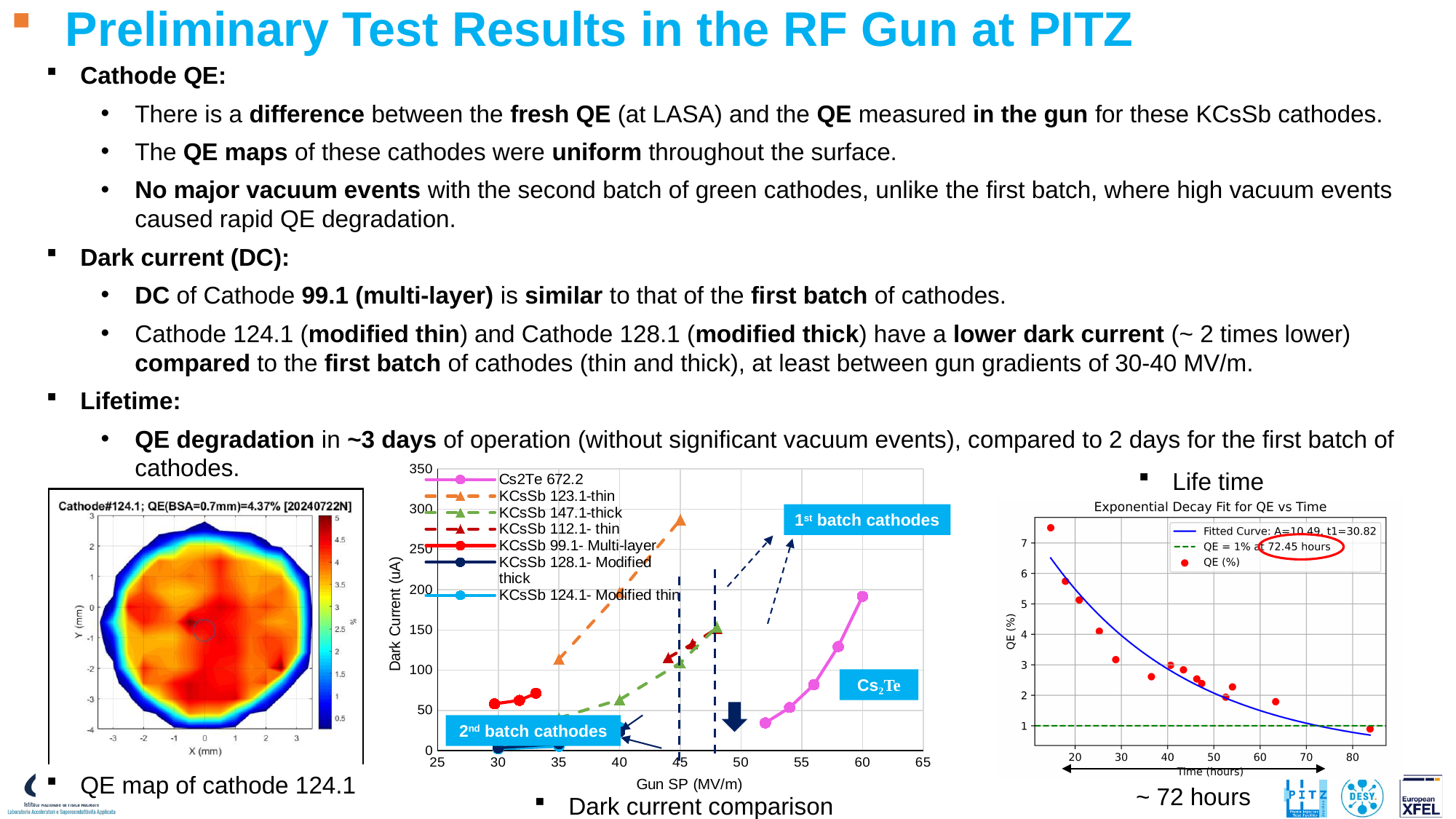
In the dark current comparison chart, how many series does the legend list? 7 In the dark current comparison chart, which series reaches the highest dark current value shown? KCsSb 123.1-thin What is the title of the lifetime chart on the right of the slide? Exponential Decay Fit for QE vs Time In the QE map of cathode 124.1, what QE value is given in the chart title? 4.37% In the dark current comparison chart, is the dark current for KCsSb 128.1- Modified thick at 45 MV/m greater or less than 50? less In the dark current comparison chart, what is the label of the x axis? Gun SP (MV/m) In the dark current comparison chart, is the dark current for Cs2Te 672.2 at 52 MV/m greater or less than 50? less In the Exponential Decay Fit for QE vs Time chart, does QE rise or fall as time increases? fall In the dark current comparison chart, does the dark current of Cs2Te 672.2 rise or fall as Gun SP increases? rise In the dark current comparison chart, is the dark current for KCsSb 123.1-thin at 45 MV/m greater or less than 250? greater In the Exponential Decay Fit for QE vs Time chart, at how many hours does the legend say QE = 1%? 72.45 hours In the dark current comparison chart, what is the label of the y axis? Dark Current (uA)